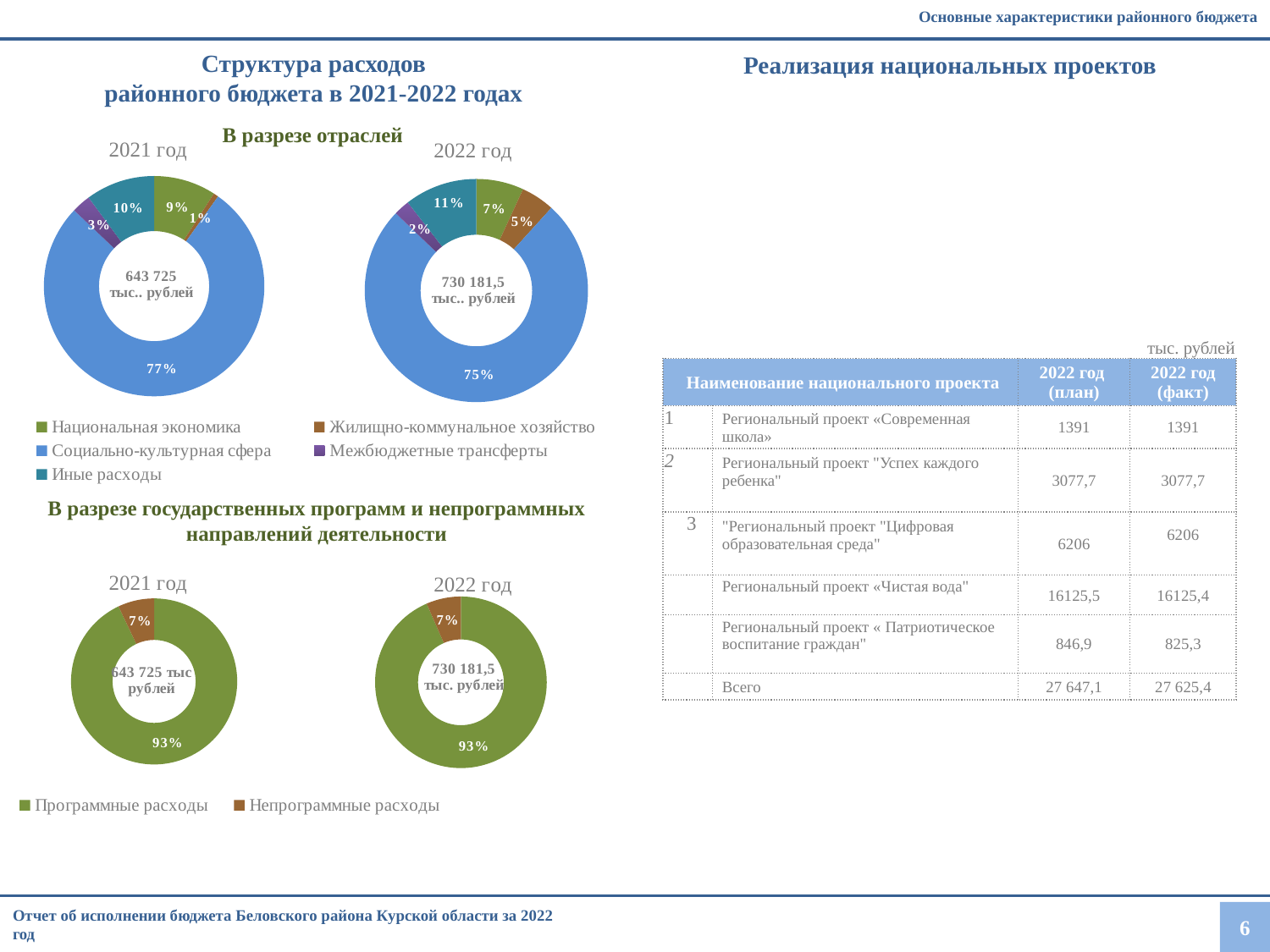
In the 2022 год doughnut chart under «В разрезе отраслей», what share is shown for Социально-культурная сфера? 75% In the 2022 год doughnut chart under «В разрезе отраслей», what share is shown for Иные расходы? 11% Under «В разрезе отраслей», is the Жилищно-коммунальное хозяйство share larger in the 2021 год chart or the 2022 год chart? 2022 год What type of chart is used for the 2022 год chart under «В разрезе отраслей»? Doughnut chart In the 2021 год chart under «В разрезе государственных программ и непрограммных направлений деятельности», what share is shown for Непрограммные расходы? 7% What is the difference between the Иные расходы share in the 2022 год chart and in the 2021 год chart under «В разрезе отраслей»? 1% In the 2022 год doughnut chart under «В разрезе отраслей», which category has the largest share? Социально-культурная сфера How many categories does the legend list for the charts under «В разрезе отраслей»? 5 In the 2021 год doughnut chart under «В разрезе отраслей», what share is shown for Социально-культурная сфера? 77% In the 2022 год chart under «В разрезе государственных программ и непрограммных направлений деятельности», what share is shown for Программные расходы? 93% In the 2021 год doughnut chart under «В разрезе отраслей», which category has the smallest share? Жилищно-коммунальное хозяйство In the 2021 год doughnut chart under «В разрезе отраслей», what share is shown for Национальная экономика? 9%